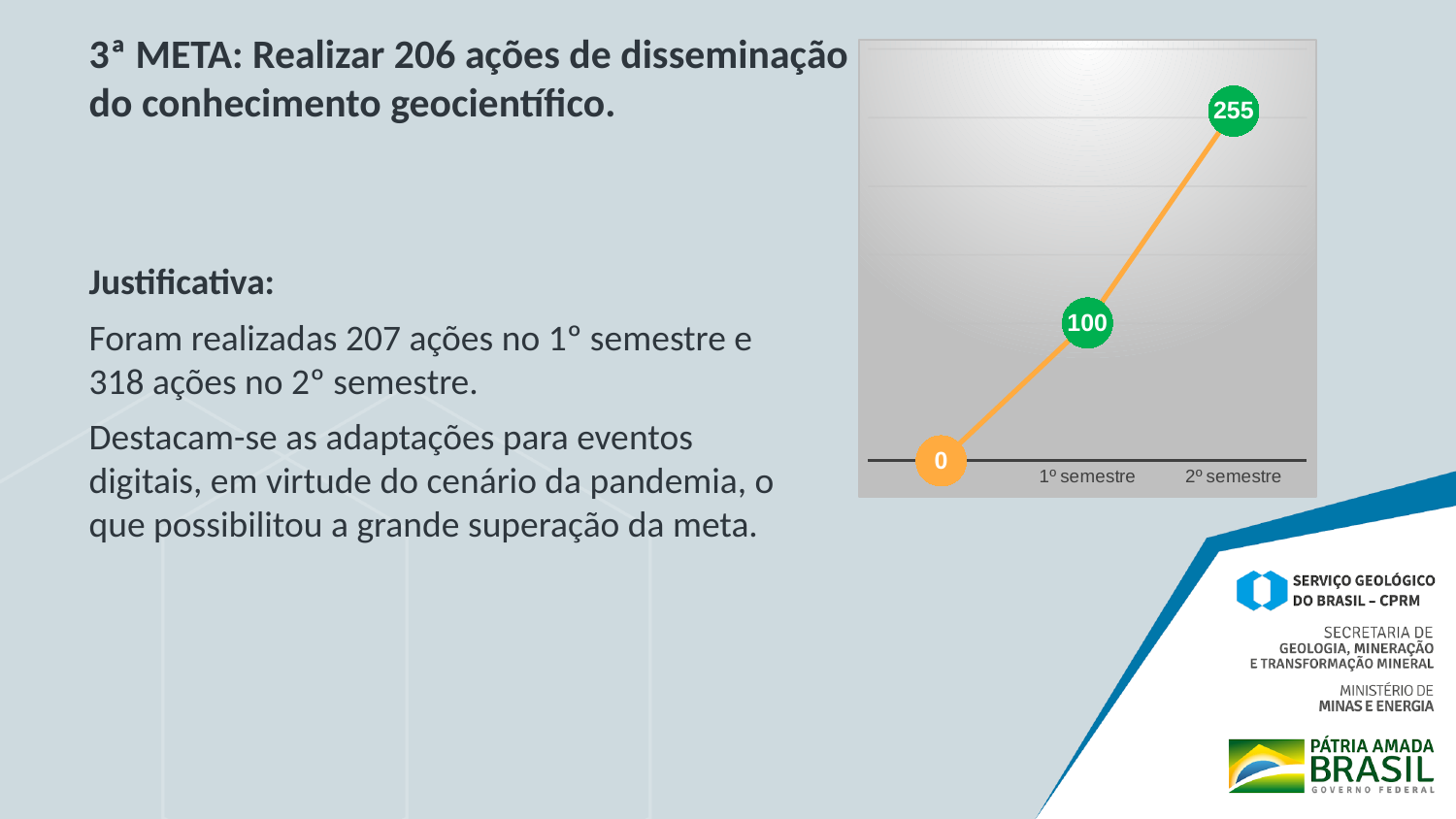
Which is larger, the value for 1º semestre or the value for 2º semestre? 2º semestre Do the values rise or fall from left to right along the x axis? Rise What value is shown for 2º semestre on the chart? 255 What value is shown for 1º semestre on the chart? 100 What is the value of the first (leftmost) data point on the chart? 0 Which labelled category has the highest value on the chart? 2º semestre What colour are the data label markers for 100 and 255 on the chart? Green What is the difference between the values for 2º semestre and 1º semestre? 155 What kind of chart is shown on the slide? Line chart What colour is the line connecting the data points on the chart? Orange How many data points are plotted on the chart? 3 What is the lowest value plotted on the chart? 0